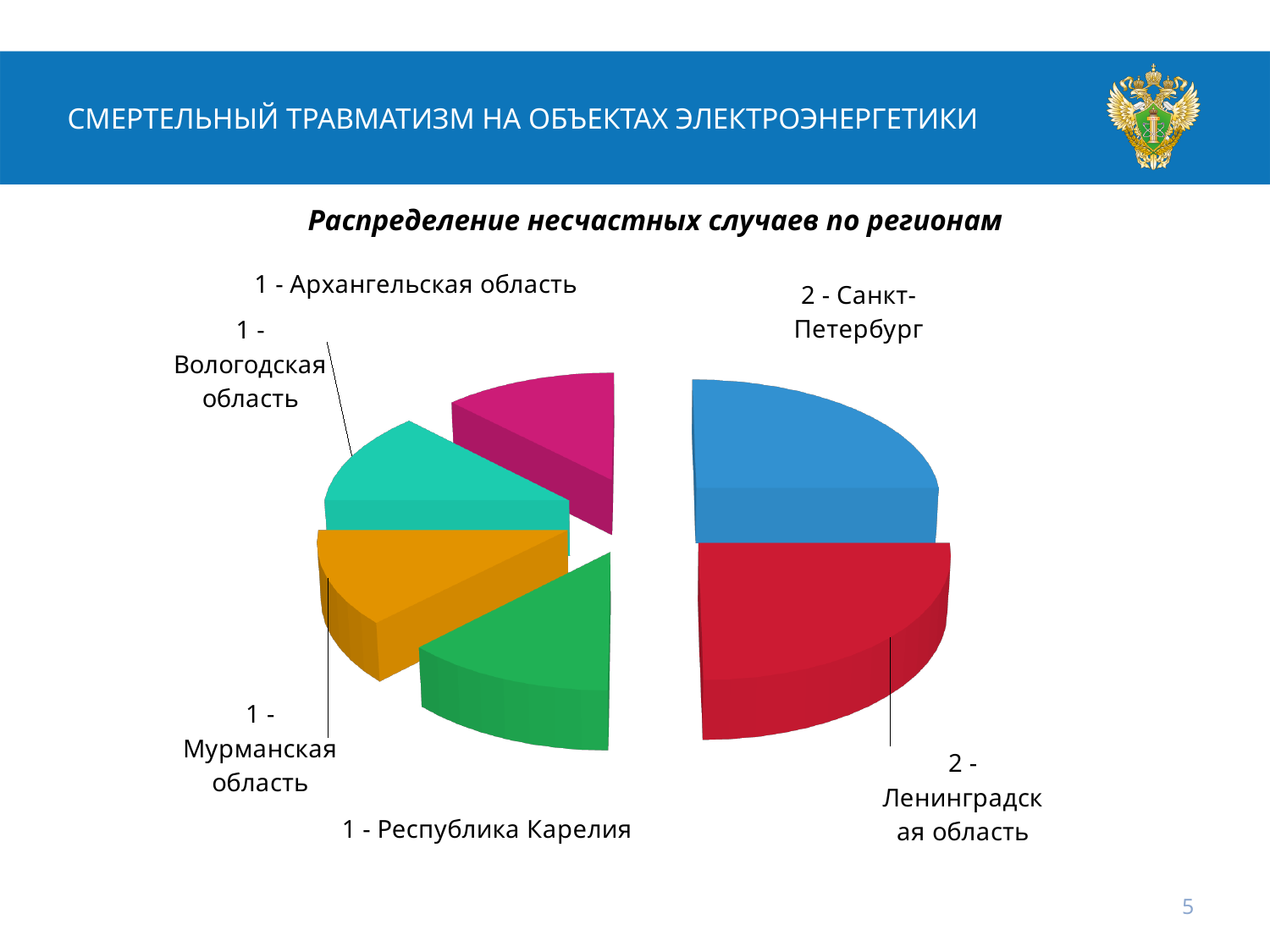
Which has more accidents, Санкт-Петербург or Вологодская область? Санкт-Петербург How many regions (slices) does the pie chart show? 6 What is the total number of accidents across all regions in the pie chart? 8 How many accidents are shown for Республика Карелия? 1 How many accidents are shown for Архангельская область? 1 What kind of chart is shown on the slide? pie chart What is the title of the chart? Распределение несчастных случаев по регионам How many accidents are shown for Санкт-Петербург? 2 How many accidents are shown for Ленинградская область? 2 How many accidents are shown for Мурманская область? 1 What is the difference between the number of accidents in Ленинградская область and in Мурманская область? 1 What share of all accidents does Санкт-Петербург account for? 25%